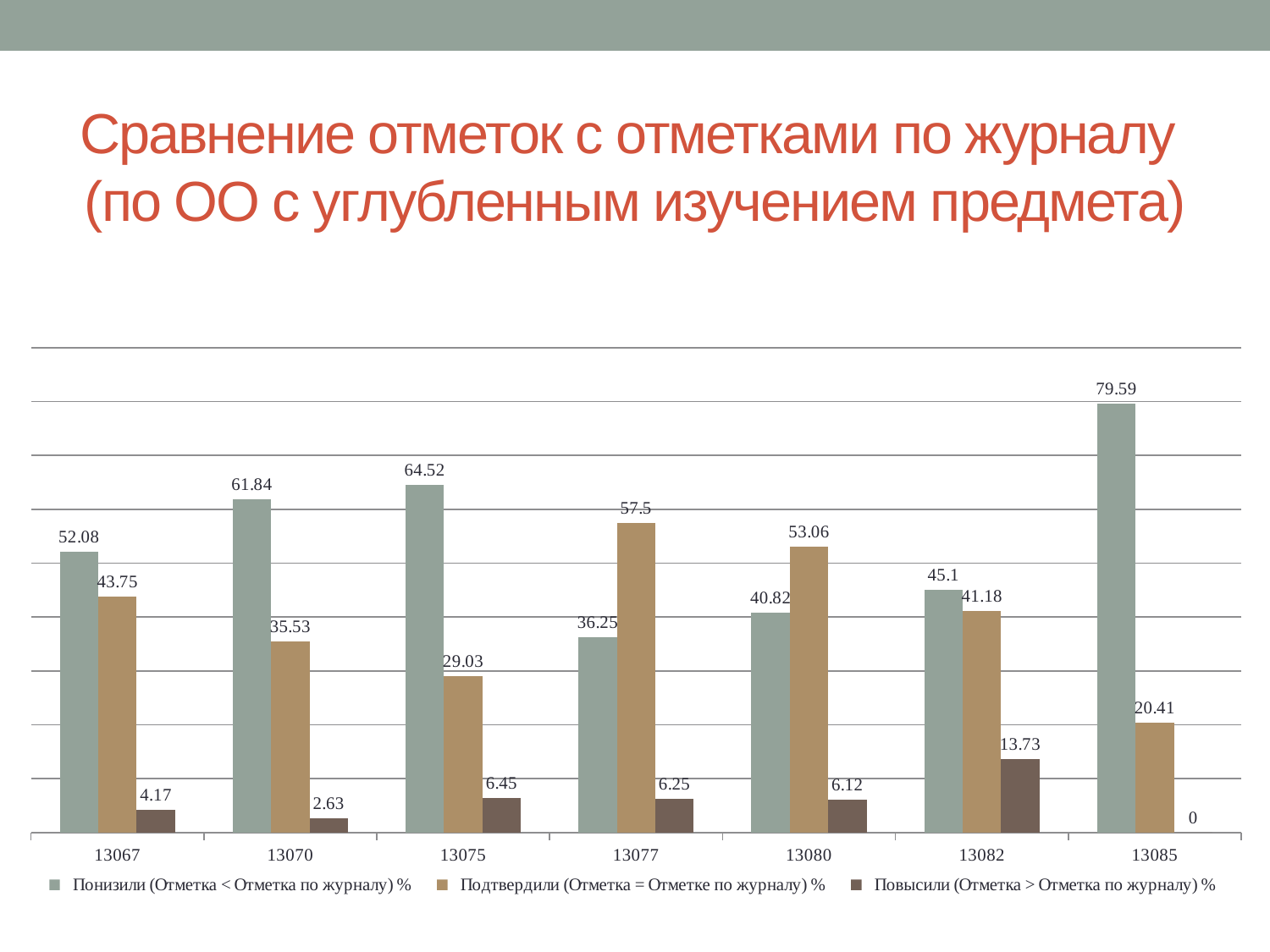
What is the difference between the "Понизили" and "Подтвердили" values for category 13067? 8.33 Which category has the lowest value in the "Повысили (Отметка > Отметка по журналу) %" series? 13085 Which category has the lowest value in the "Подтвердили (Отметка = Отметке по журналу) %" series? 13085 What kind of chart is shown on the slide? Bar chart Which category has the highest value in the "Понизили (Отметка < Отметка по журналу) %" series? 13085 What is the title of the slide containing the chart? Сравнение отметок с отметками по журналу (по ОО с углубленным изучением предмета) How many series does the chart legend list? 3 What is the value of the "Подтвердили (Отметка = Отметке по журналу) %" series for category 13077? 57.5 How many categories are shown on the x axis of the chart? 7 What is the value of the "Повысили (Отметка > Отметка по журналу) %" series for category 13082? 13.73 For category 13080, which is larger: the "Понизили" value or the "Подтвердили" value? Подтвердили (Отметка = Отметке по журналу) % What is the value of the "Понизили (Отметка < Отметка по журналу) %" series for category 13085? 79.59